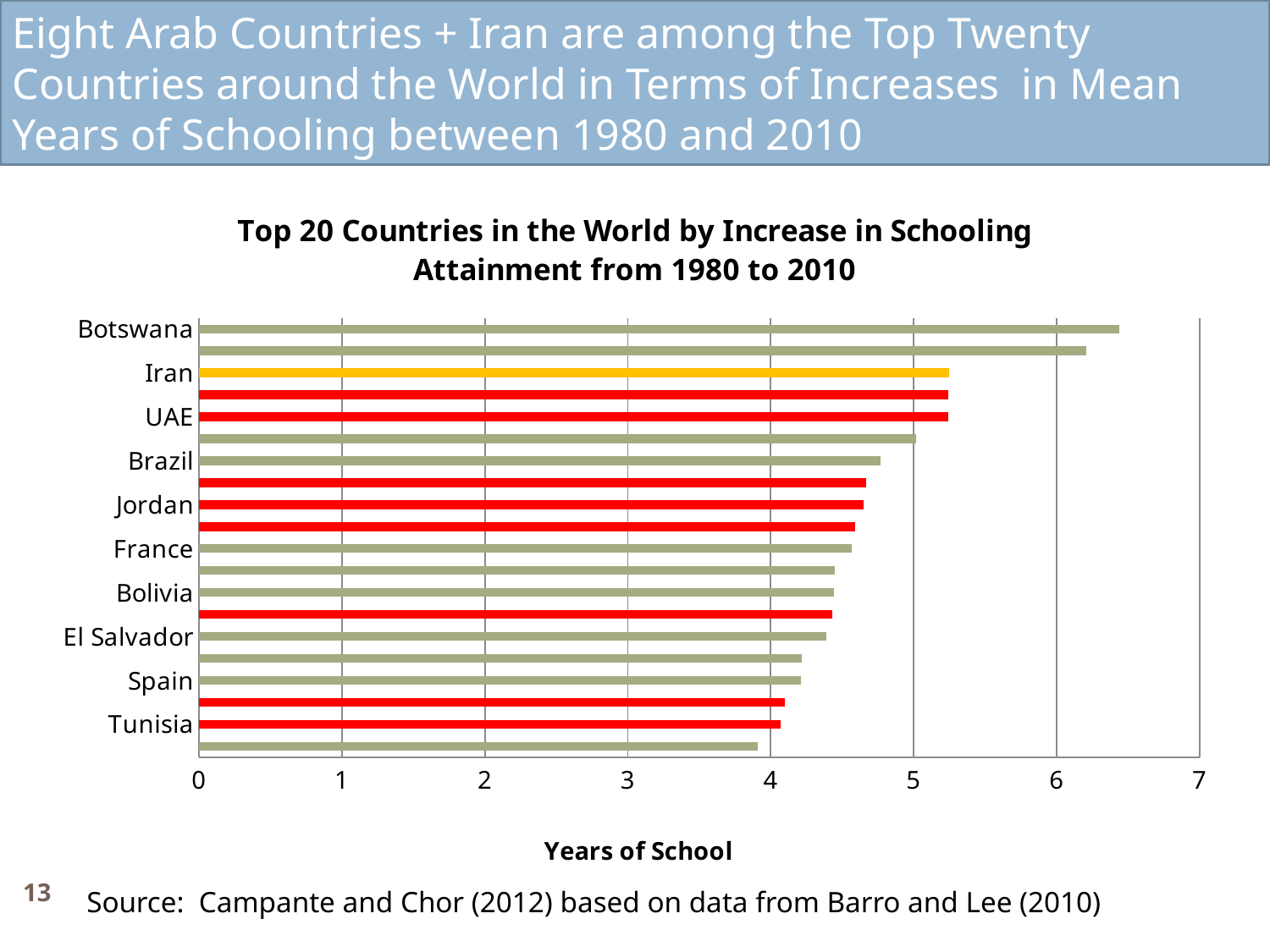
How many bars are plotted in the chart? 20 Is the value for Brazil greater or less than 5? less Is the value for Botswana greater or less than 6? greater Is the value for UAE greater or less than 5? greater What kind of chart is shown on the slide? bar chart What is the label of the horizontal axis? Years of School Do the bar values rise or fall going from the top of the chart to the bottom? fall Which has a larger value, Botswana or Tunisia? Botswana Which labeled country has the highest increase in years of schooling? Botswana